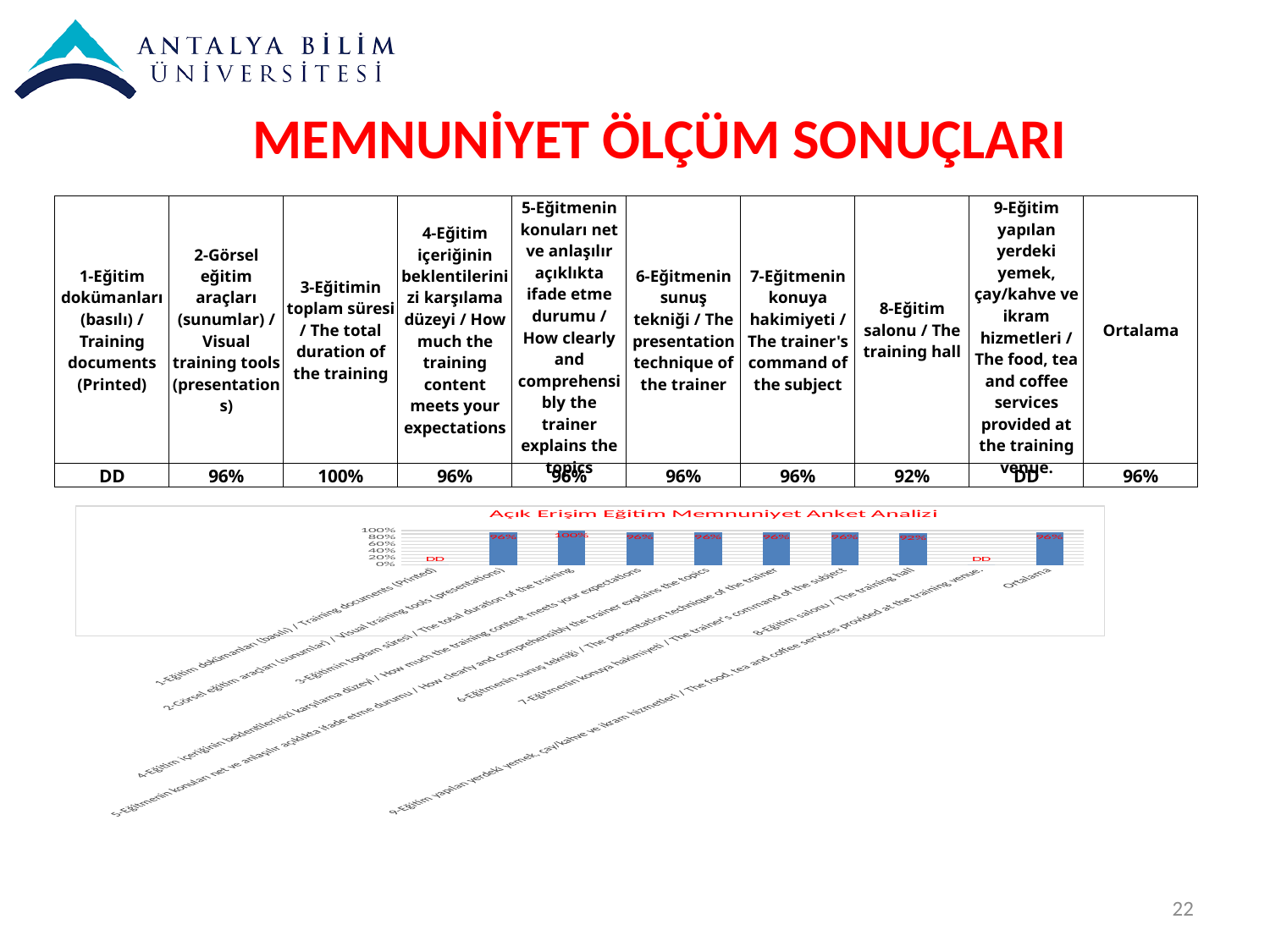
What value does the chart show for '3-Eğitimin toplam süresi / The total duration of the training'? 100% Is the value for '7-Eğitmenin konuya hakimiyeti / The trainer's command of the subject' greater or less than 80%? greater Which category has the highest value in the chart? 3-Eğitimin toplam süresi / The total duration of the training Among the categories with a percentage value, which has the lowest value? 8-Eğitim salonu / The training hall How many categories are shown on the x axis of the chart? 10 Which is larger: the value for '6-Eğitmenin sunuş tekniği / The presentation technique of the trainer' or the value for '8-Eğitim salonu / The training hall'? 6-Eğitmenin sunuş tekniği / The presentation technique of the trainer What value does the chart show for '2-Görsel eğitim araçları (sunumlar) / Visual training tools (presentations)'? 96% What value does the chart show for 'Ortalama'? 96% What is the difference between the value for '3-Eğitimin toplam süresi / The total duration of the training' and the value for '8-Eğitim salonu / The training hall'? 8% What value does the chart show for '8-Eğitim salonu / The training hall'? 92% What is the title of the chart? Açık Erişim Eğitim Memnuniyet Anket Analizi What kind of chart is shown on the slide? bar chart